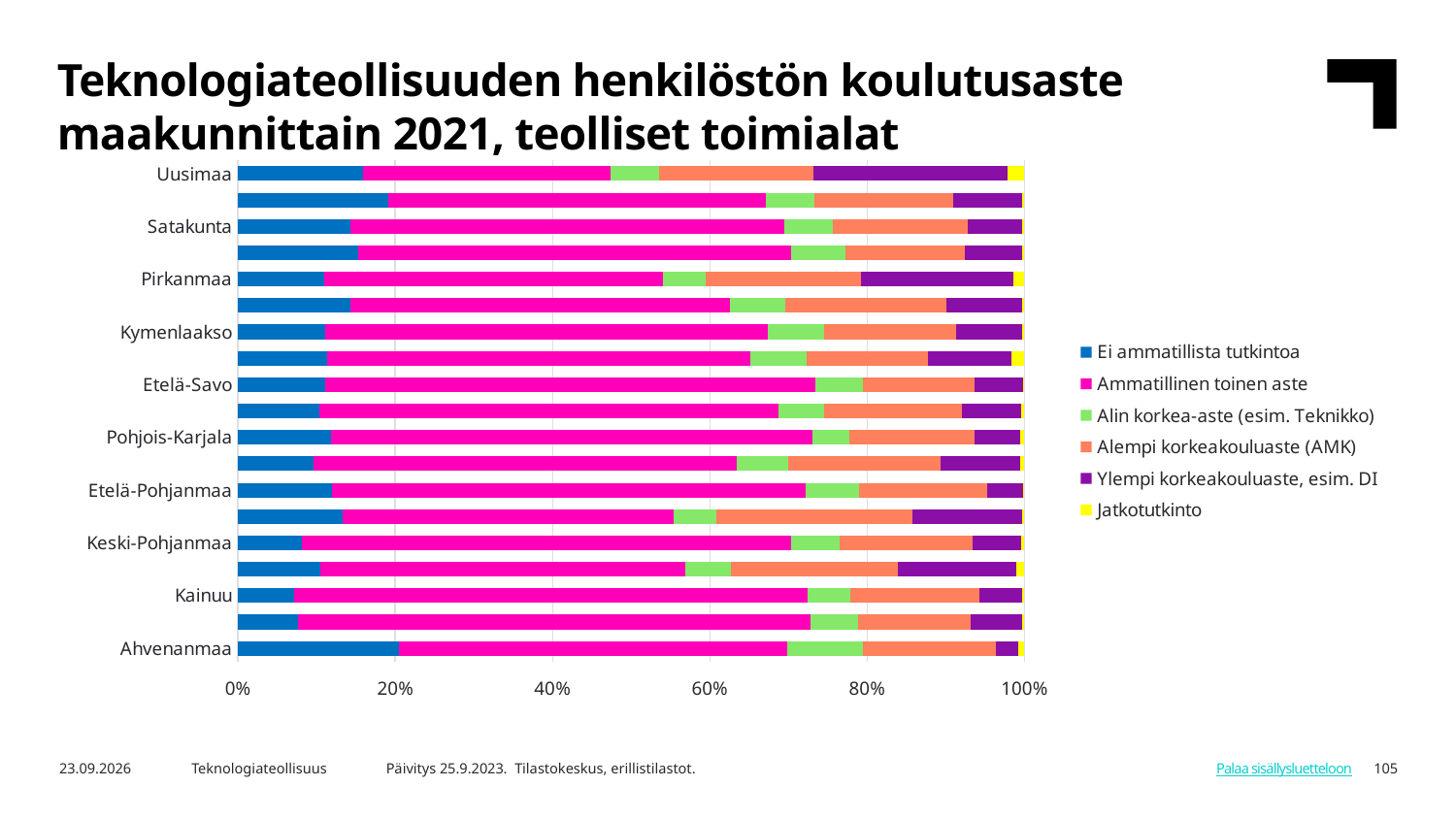
Which legend entry is shown in yellow? Jatkotutkinto How many series does the legend list? 6 How many bars (regions) are plotted in the chart? 19 Is the 'Ammatillinen toinen aste' share for Uusimaa greater or less than 40%? less Is the 'Ammatillinen toinen aste' share for Ahvenanmaa greater or less than 40%? greater Is the 'Ylempi korkeakouluaste, esim. DI' share for Kainuu greater or less than 20%? less What is the title of the chart on the slide? Teknologiateollisuuden henkilöstön koulutusaste maakunnittain 2021, teolliset toimialat What kind of chart is shown on the slide? Stacked bar chart Which has the larger 'Ylempi korkeakouluaste, esim. DI' share, Uusimaa or Kainuu? Uusimaa Which has the larger 'Ei ammatillista tutkintoa' share, Uusimaa or Kainuu? Uusimaa